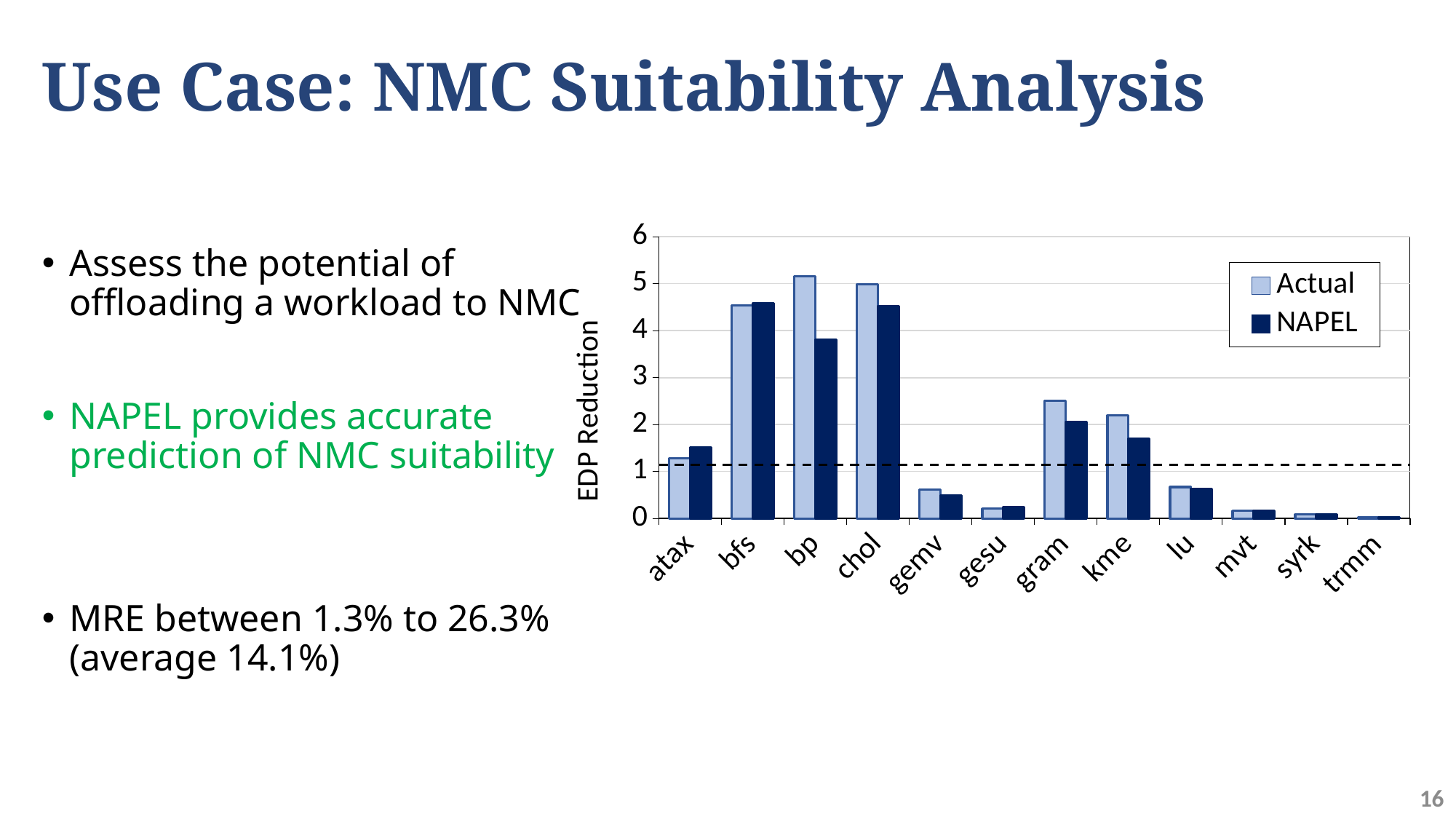
Which workload has the lowest Actual EDP Reduction? trmm Is the Actual value for gram greater or less than 2? greater How many series does the legend list? 2 What is the label of the y axis? EDP Reduction What kind of chart is shown on the slide? bar chart Is the Actual value for bp greater or less than 5? greater For atax, which is larger: the Actual value or the NAPEL value? NAPEL Is the Actual value for lu greater or less than 1? less How many workload categories are shown on the x axis? 12 Which workload has the highest Actual EDP Reduction? bp For bp, which is larger: the Actual value or the NAPEL value? Actual